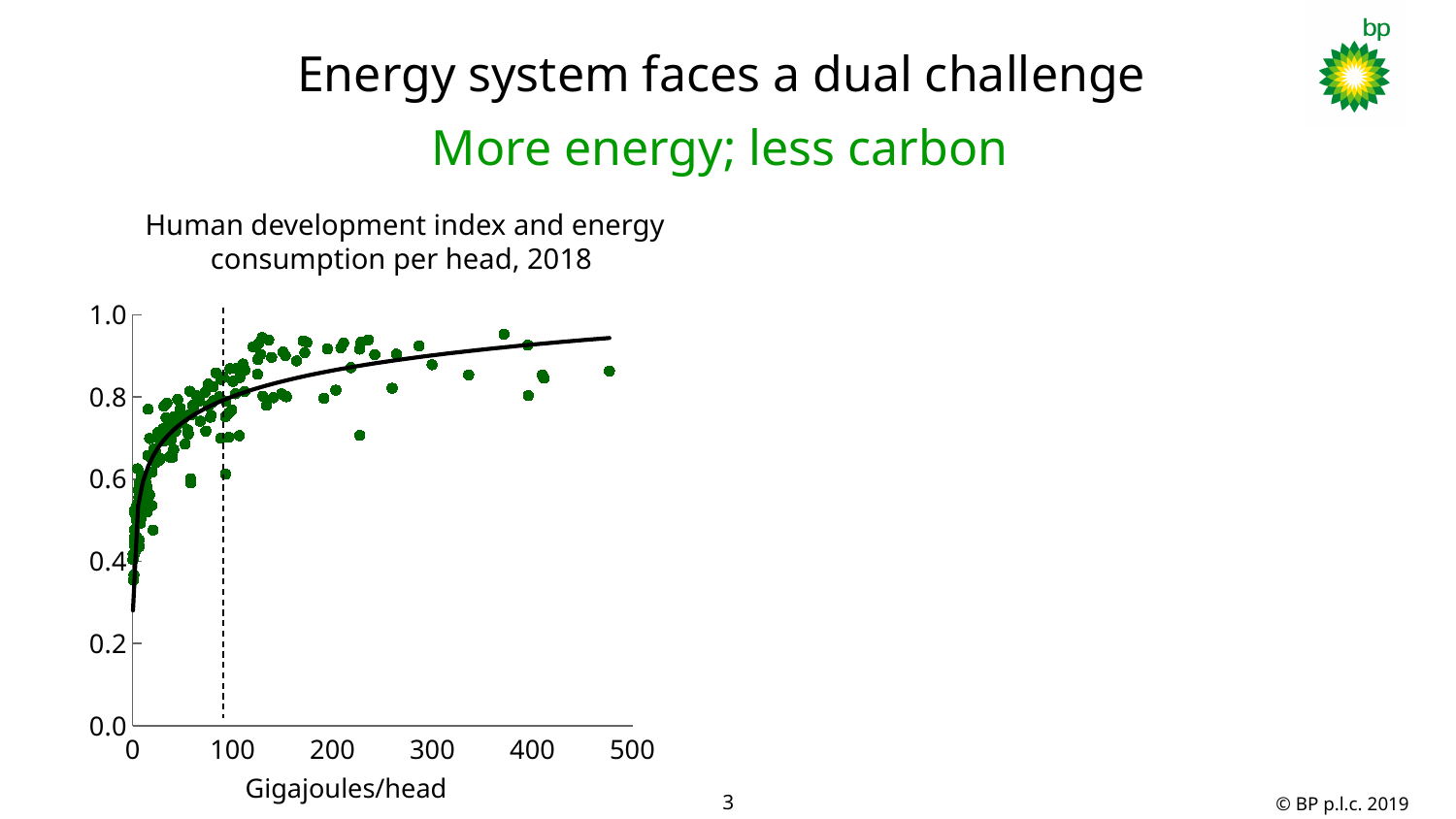
Is the human development index of the point with the highest energy consumption (near 480 gigajoules/head) greater or less than 0.8? greater What is the label on the x axis of the chart? Gigajoules/head What kind of chart is shown on the slide? Scatter chart What is the highest value shown on the x axis of the chart? 500 Does the human development index generally rise or fall as energy consumption per head increases along the x axis? Rise Is the vertical dashed line on the chart positioned at less than or greater than 200 gigajoules/head? less Is the fitted curve's value at 500 gigajoules/head greater or less than 0.8? greater What is the highest value shown on the y axis of the chart? 1.0 What is the lowest value shown on the y axis of the chart? 0.0 What is the title of the chart? Human development index and energy consumption per head, 2018